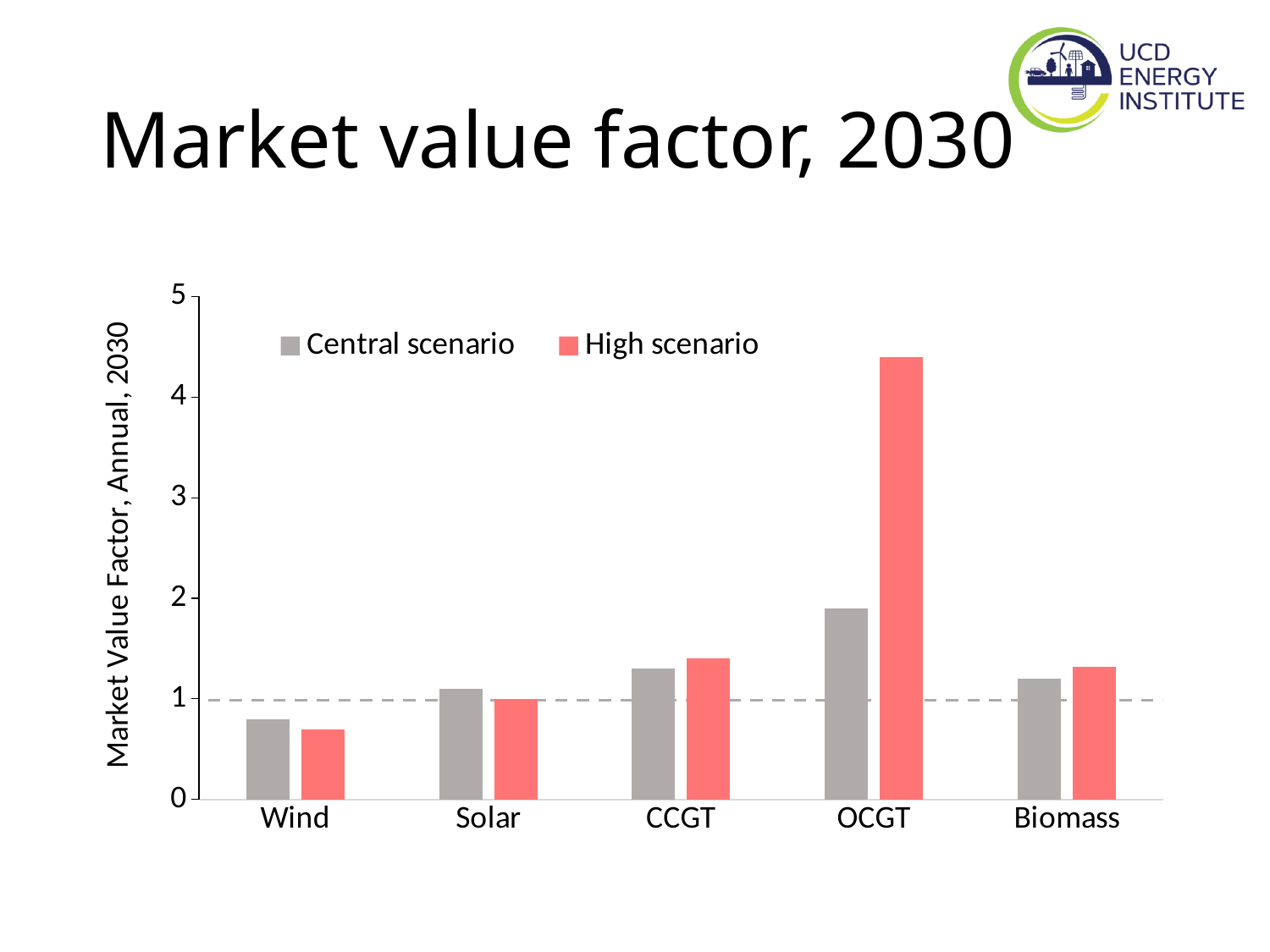
Which category has the highest value in the Central scenario series? OCGT Is the Central scenario value for Wind greater or less than 1? less For OCGT, which is larger: the Central scenario value or the High scenario value? High scenario What is the title of the y axis? Market Value Factor, Annual, 2030 How many series does the legend list? 2 Which category has the lowest value in the High scenario series? Wind What kind of chart is shown on the slide? bar chart Is the Central scenario value for OCGT greater or less than 2? less Which category has the lowest value in the Central scenario series? Wind How many categories are shown on the x axis? 5 Is the High scenario value for OCGT greater or less than 4? greater Which category has the highest value in the High scenario series? OCGT